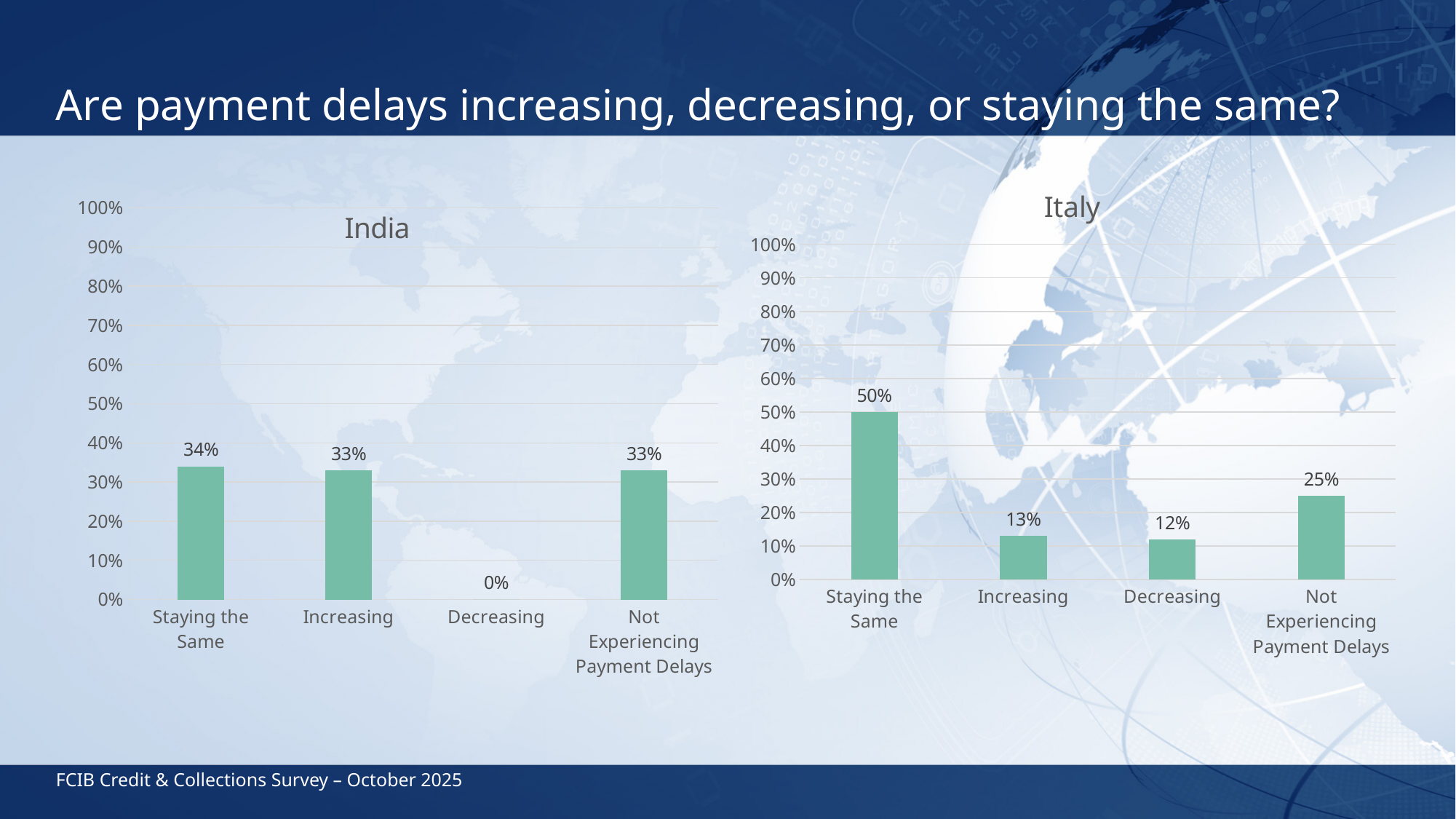
In the Italy chart, what is the value for Not Experiencing Payment Delays? 25% In the Italy chart, what is the difference between Staying the Same and Not Experiencing Payment Delays? 25% In the Italy chart, what is the value for Staying the Same? 50% In the India chart, which category has the lowest value? Decreasing How many categories are shown in the India chart? 4 In the India chart, what is the difference between Increasing and Decreasing? 33% What kind of chart is the Italy chart? bar chart What is the title of the chart on the left side of the slide? India In the India chart, what is the value for Staying the Same? 34% In the India chart, what is the value for Decreasing? 0% In the Italy chart, is the value for Increasing greater or less than 20%? less In the Italy chart, which category has the highest value? Staying the Same